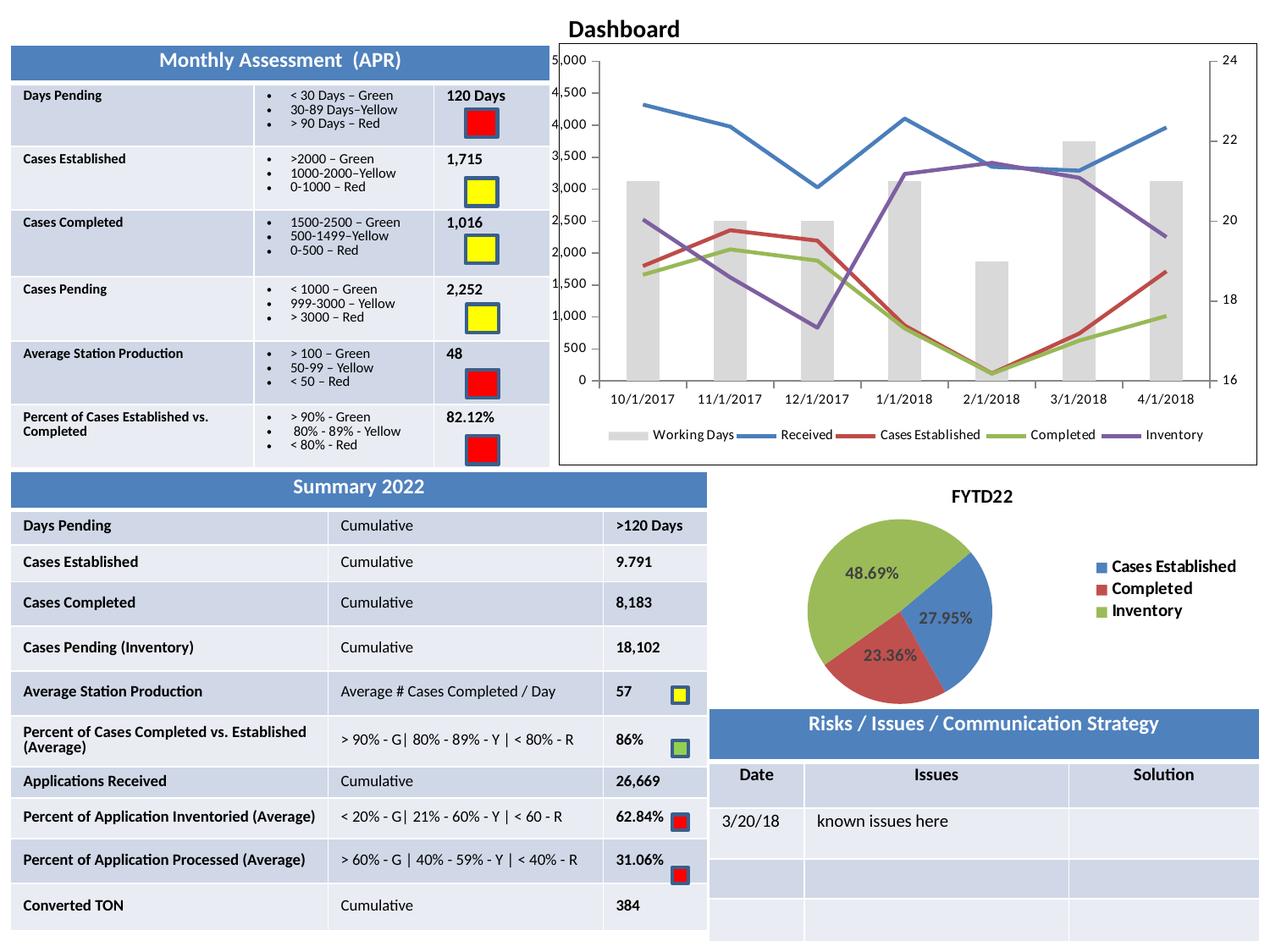
In the FYTD22 pie chart, which category has the smallest slice? Completed In the FYTD22 pie chart, which category has the largest slice? Inventory In the FYTD22 pie chart, what is the difference between the Cases Established share and the Completed share? 4.59% How many series does the legend of the top-right chart list? 5 In the top-right chart, does the Received line rise or fall from 10/1/2017 to 12/1/2017? fall How many dates are shown on the x axis of the top-right chart? 7 In the FYTD22 pie chart, what share does Completed have? 23.36% In the FYTD22 pie chart, what share does Cases Established have? 27.95% What kind of chart is the chart at the top right of the slide? Combined bar and line chart In the FYTD22 pie chart, what share does Inventory have? 48.69% How many categories does the legend of the FYTD22 pie chart list? 3 In the top-right chart, is the Received value for 10/1/2017 greater or less than 4,000? greater